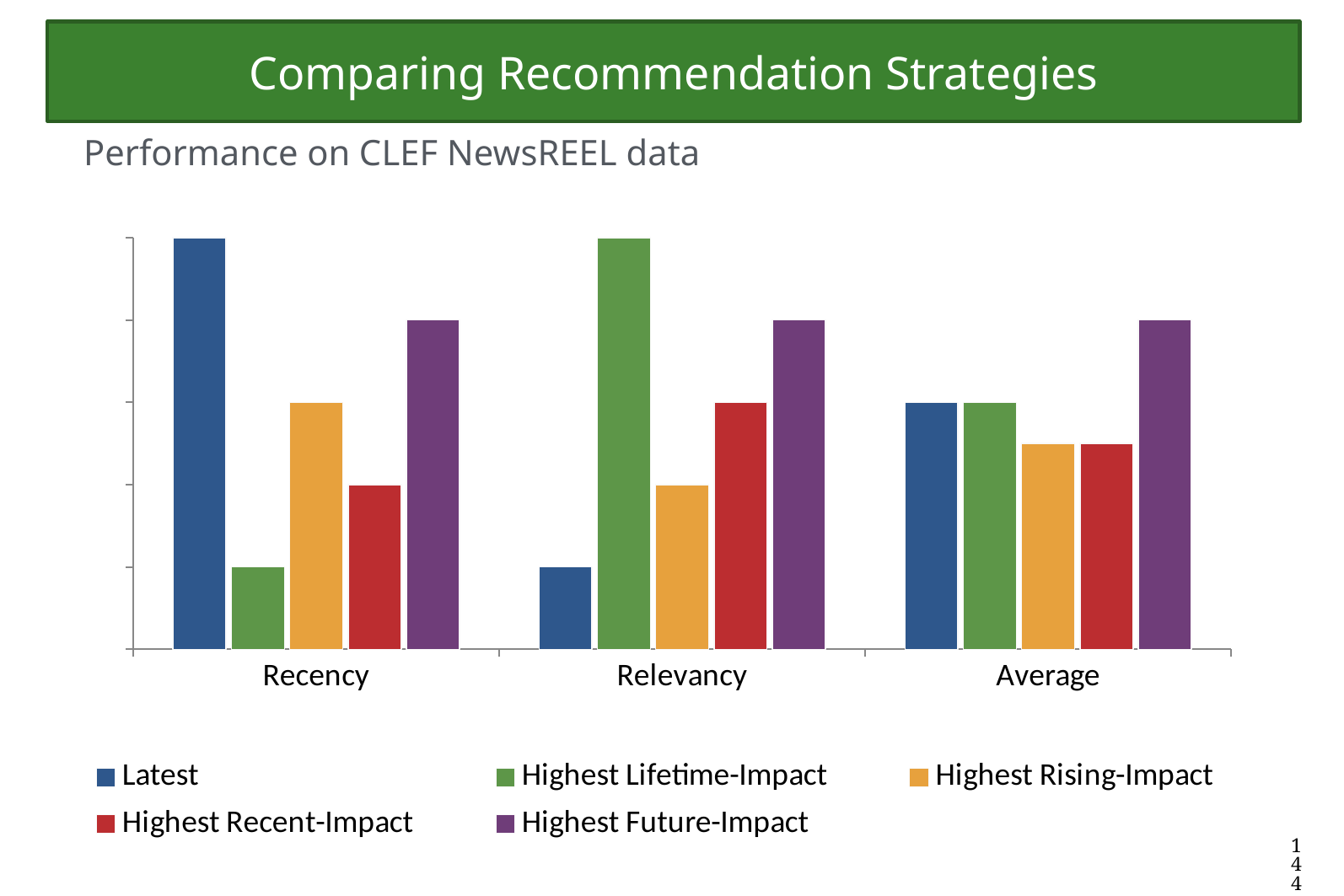
How many categories are shown on the x axis of the chart? 3 What kind of chart is shown on the slide? Bar chart Which strategy has the highest value for Relevancy? Highest Lifetime-Impact Which strategy has the highest value for Average? Highest Future-Impact For Recency, which is larger: Highest Rising-Impact or Highest Recent-Impact? Highest Rising-Impact How many series does the chart's legend list? 5 What is the subtitle shown above the chart? Performance on CLEF NewsREEL data Which strategy has the highest value for Recency? Latest Which strategy has the lowest value for Relevancy? Latest Which strategy has the lowest value for Recency? Highest Lifetime-Impact For Relevancy, which is larger: Highest Recent-Impact or Highest Rising-Impact? Highest Recent-Impact For Average, which is larger: Highest Future-Impact or Latest? Highest Future-Impact